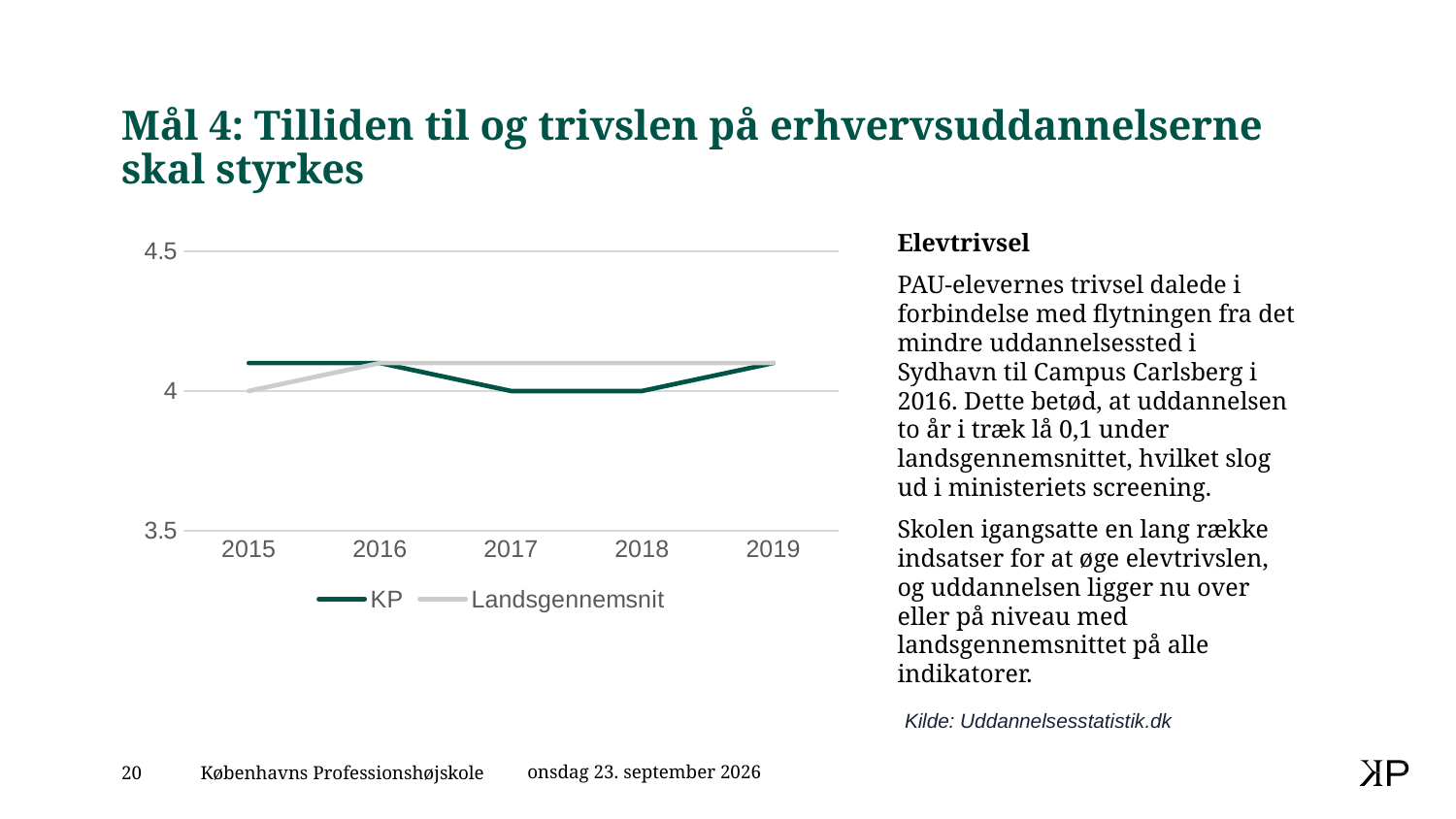
Does the KP line rise or fall from 2016 to 2017? Fall Is the value for KP in 2019 greater or less than 4.5? less How many years are shown on the x axis of the chart? 5 In 2017, which series has the higher value, KP or Landsgennemsnit? Landsgennemsnit What colour is the KP line in the chart? Dark green How many series does the chart legend list? 2 What kind of chart is shown on the slide? Line chart Is the value for KP in 2015 greater or less than 4? greater Which two series are listed in the chart legend? KP and Landsgennemsnit In 2015, which series has the higher value, KP or Landsgennemsnit? KP Is the value for Landsgennemsnit in 2017 greater or less than 4? greater Does the KP line rise or fall from 2018 to 2019? Rise